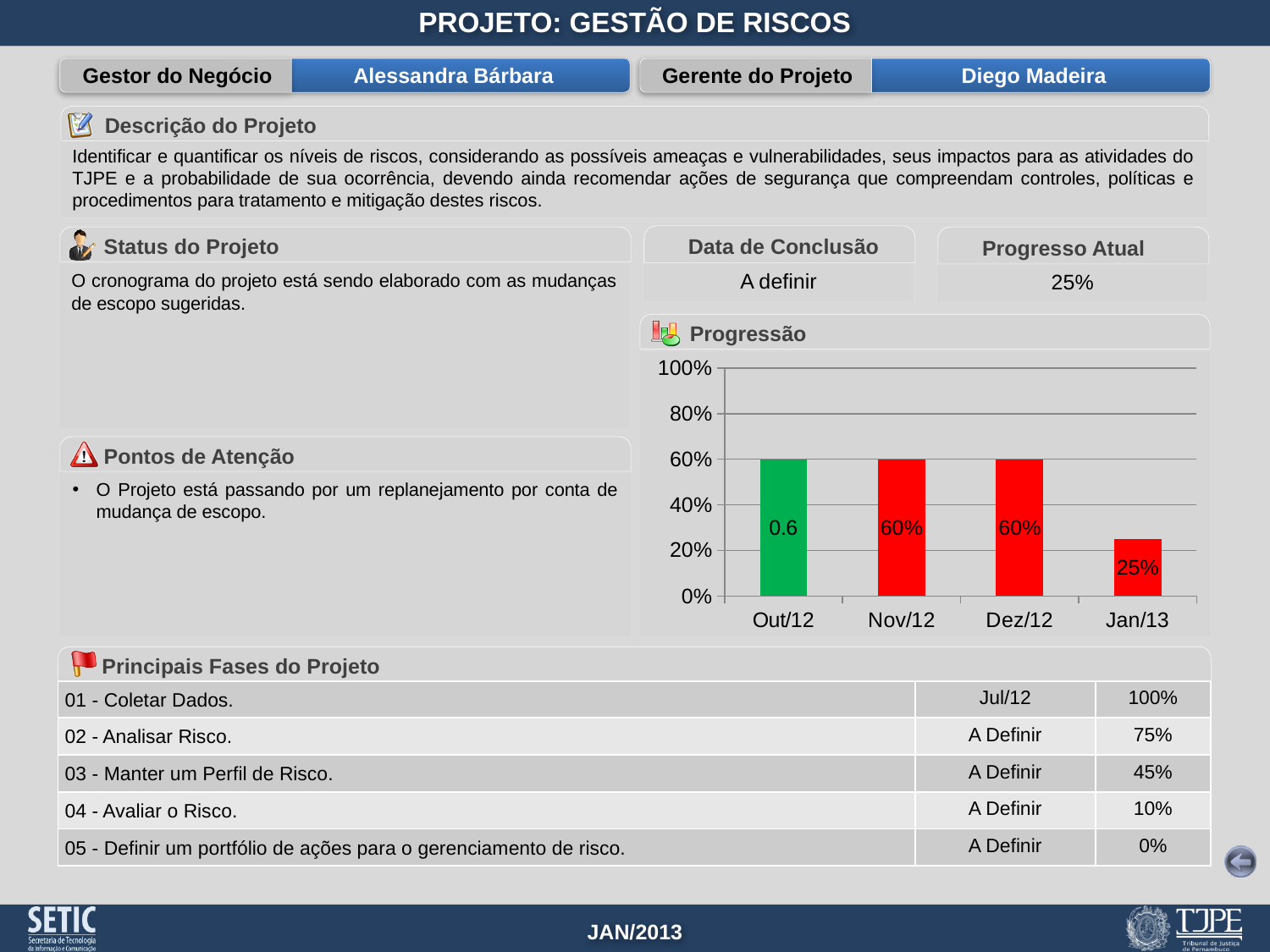
In the Progressão chart, do the values rise or fall from Dez/12 to Jan/13? fall In the Progressão chart, which month has the lowest value? Jan/13 In the Progressão chart, what is the value for Dez/12? 60% How many months are shown on the x axis of the Progressão chart? 4 What kind of chart is the Progressão chart? bar chart What colour is the Out/12 bar in the Progressão chart? green In the Progressão chart, what is the difference between the values for Dez/12 and Jan/13? 35% In the Progressão chart, is the value for Jan/13 greater or less than 40%? less In the Progressão chart, what is the value for Nov/12? 60% In the Progressão chart, what data label is printed on the Out/12 bar? 0.6 In the Progressão chart, which is larger, the value for Nov/12 or the value for Jan/13? Nov/12 In the Progressão chart, what is the value for Jan/13? 25%